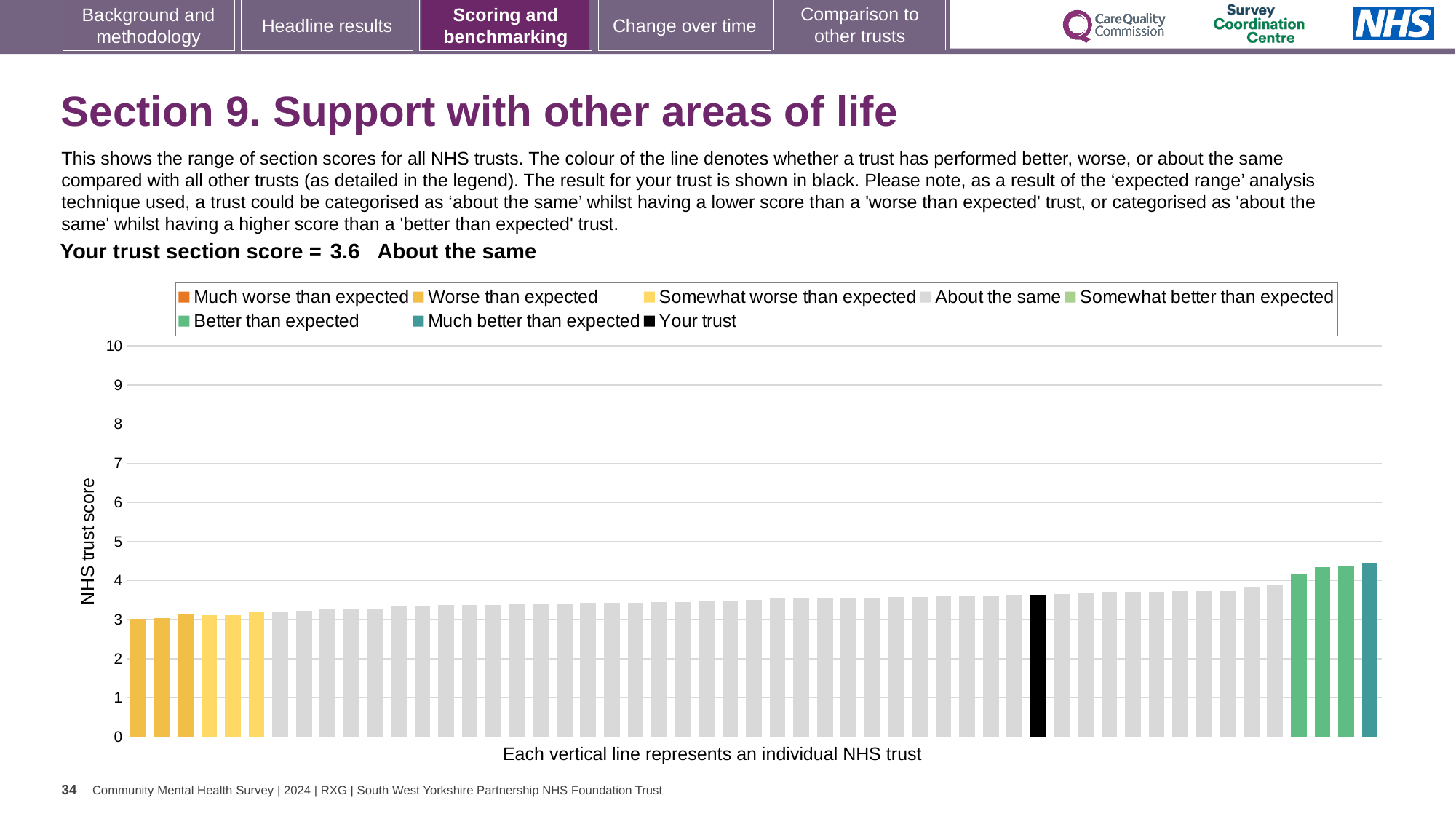
Is the shortest bar in the chart greater or less than 2? greater How many entries does the chart legend list? 8 Is the tallest bar in the chart greater or less than 4? greater Is the value for your trust greater or less than 4? less What kind of chart is shown on the slide? bar chart What colour is the bar representing your trust? black Which category is your trust placed in for this section? About the same How many bars in the chart are coloured black? 1 What is the section score for your trust shown on the slide? 3.6 Do the bar values rise or fall from left to right along the x axis? rise What is the label on the vertical axis of the chart? NHS trust score